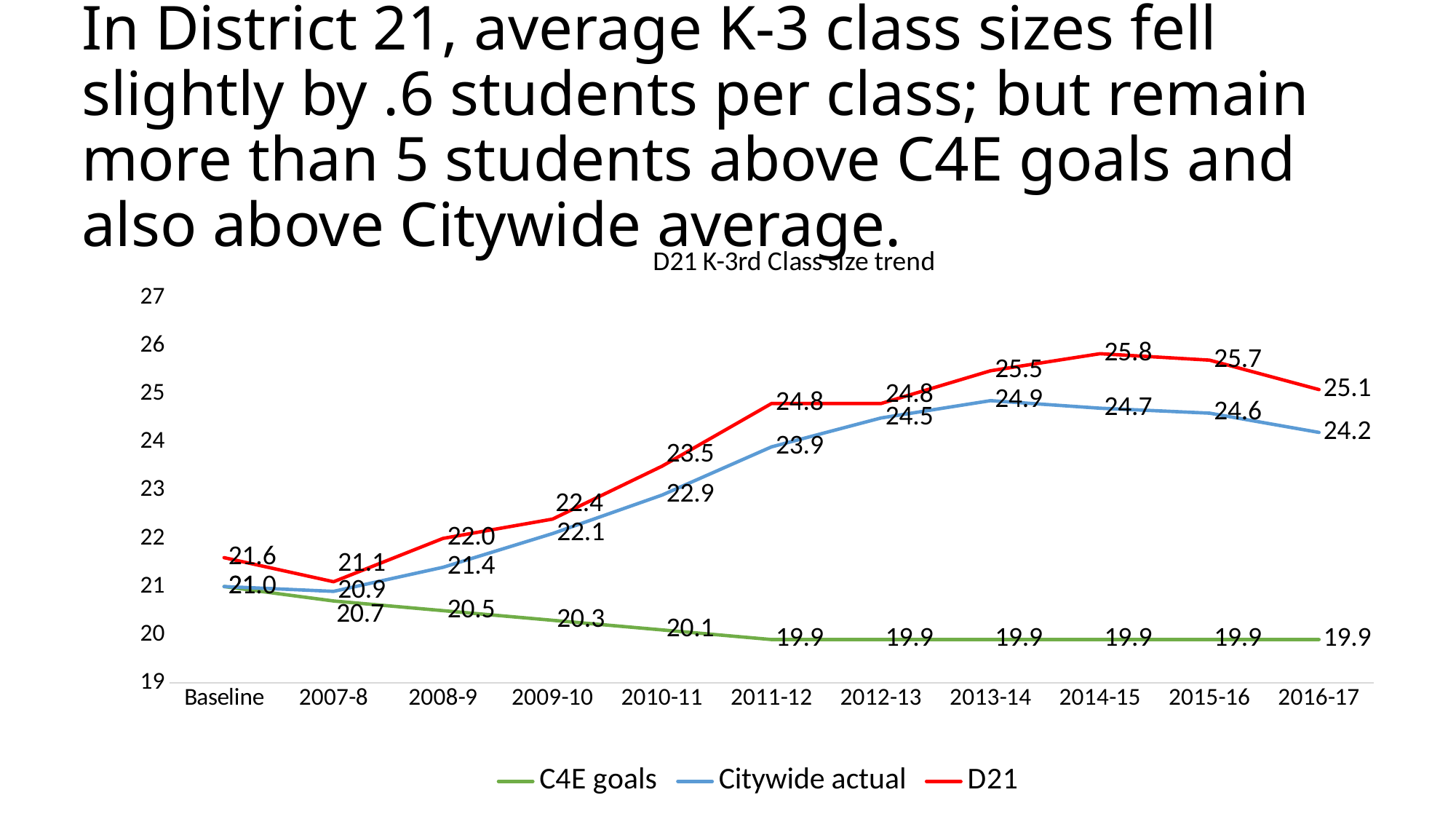
What is the D21 value for 2016-17? 25.1 How many points are plotted along the x axis for each series? 11 What kind of chart is shown on the slide? line chart Do the C4E goals values rise or fall from Baseline to 2016-17? fall In which year is the D21 series at its lowest value? 2007-8 What colour is the D21 line? red What is the difference between the D21 and Citywide actual values in 2016-17? 0.9 How many series does the legend list? 3 Which is larger in 2014-15, the D21 value or the Citywide actual value? D21 What is the C4E goals value for 2009-10? 20.3 What is the Citywide actual value for 2013-14? 24.9 In which year does the D21 series reach its highest value? 2014-15